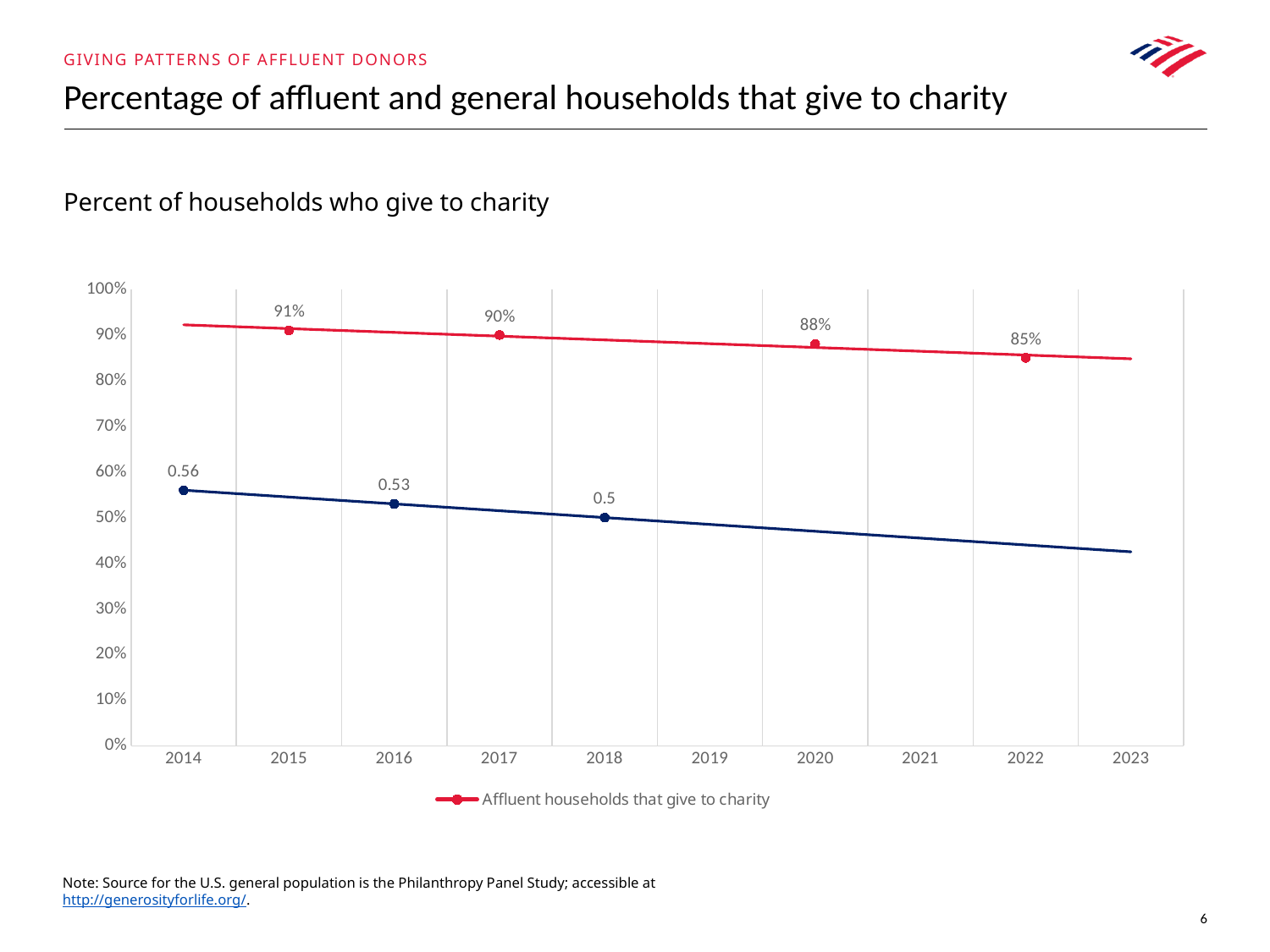
Is the value of the blue line at 2023 greater or less than 50%? less By how many percentage points did the affluent households value fall from 2015 to 2022? 6 percentage points What is the value for affluent households that give to charity in 2022? 85% What is the value for affluent households that give to charity in 2020? 88% What value is labeled on the blue line for 2014? 0.56 Does the affluent households line rise or fall from 2014 to 2023? falls What value is labeled on the blue line for 2018? 0.5 How many series does the legend list? 1 What kind of chart is shown on the slide? line chart What percentage of affluent households gave to charity in 2015? 91% In which labeled year is the affluent households value highest? 2015 In which labeled year is the affluent households value lowest? 2022